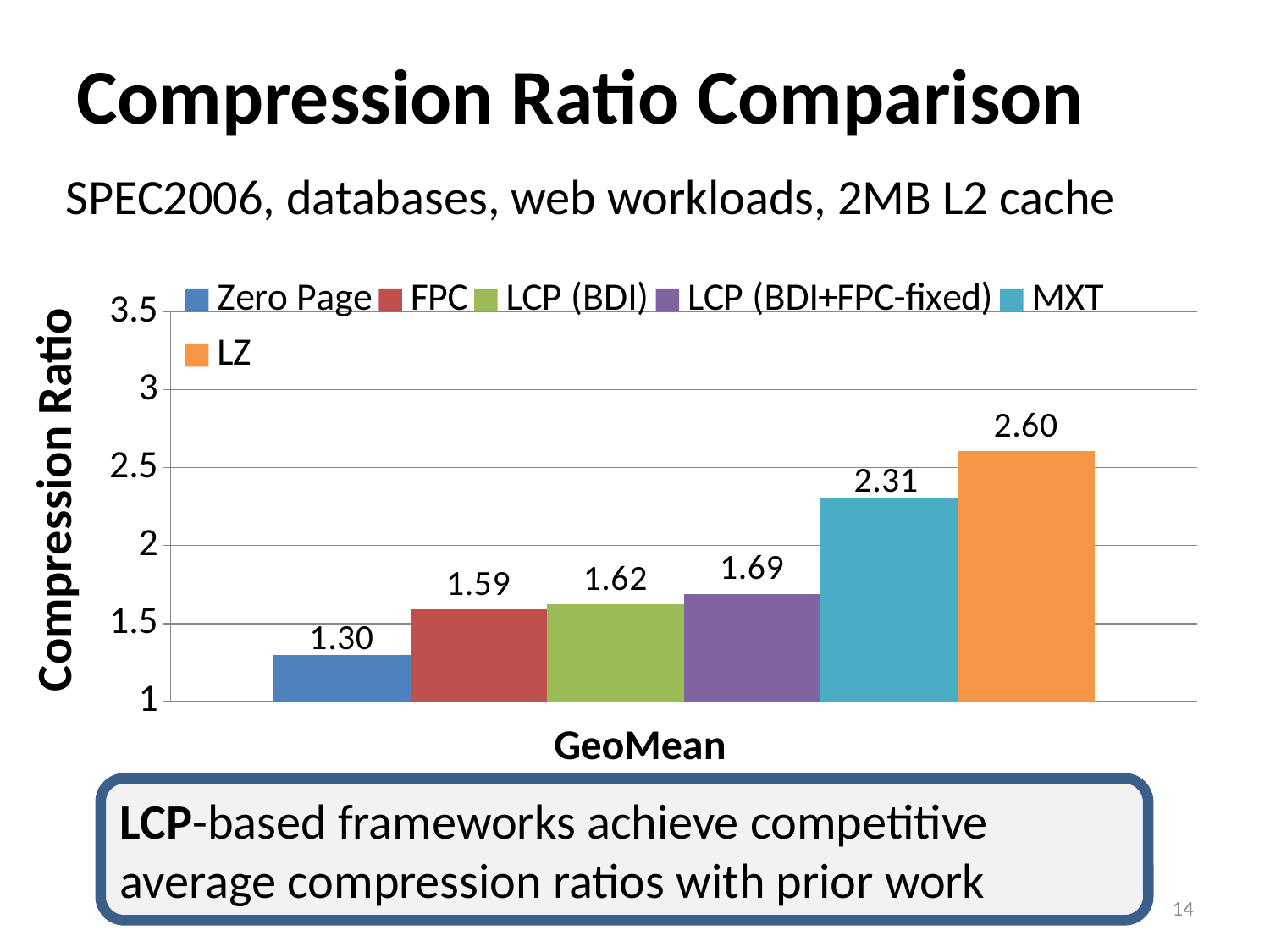
Which series has the highest compression ratio? LZ What is the difference between the compression ratios of LZ and MXT? 0.29 What kind of chart is shown on the slide? Bar chart What is the difference between the compression ratios of LCP (BDI) and FPC? 0.03 How many series does the legend list? 6 What is the compression ratio for LZ? 2.60 What is the compression ratio for Zero Page? 1.30 What is the compression ratio for MXT? 2.31 What is the compression ratio for LCP (BDI+FPC-fixed)? 1.69 Which has a higher compression ratio, MXT or LCP (BDI+FPC-fixed)? MXT What is the label on the y axis of the chart? Compression Ratio Which series has the lowest compression ratio? Zero Page